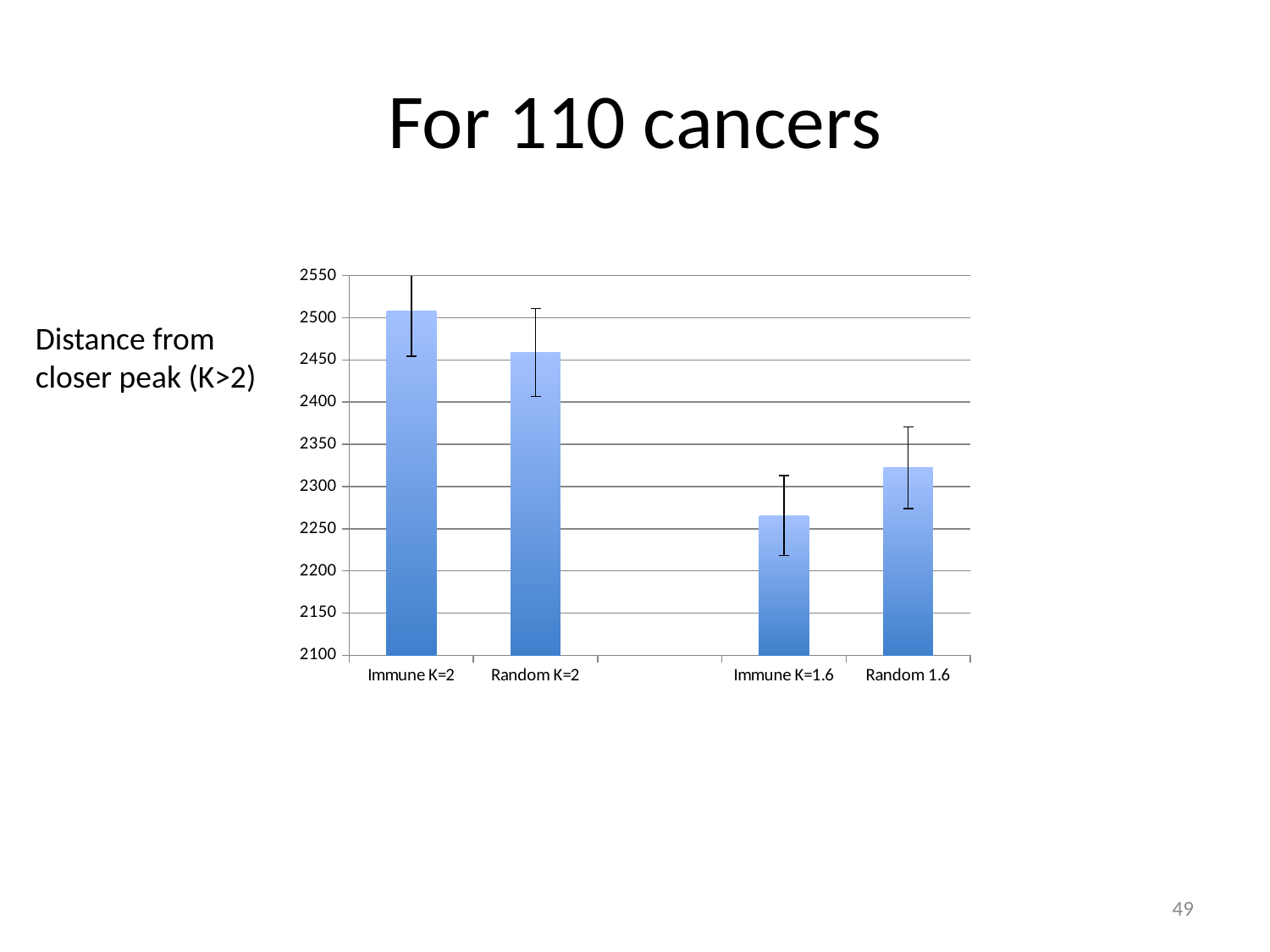
What is the title of the slide containing the chart? For 110 cancers Is the value for Immune K=2 greater or less than 2450? greater Which is larger, the value for Immune K=1.6 or the value for Random 1.6? Random 1.6 Is the value for Immune K=1.6 greater or less than 2300? less Which is larger, the value for Immune K=2 or the value for Random K=2? Immune K=2 Which category has the highest bar? Immune K=2 Which category has the lowest bar? Immune K=1.6 Is the value for Random K=2 greater or less than 2400? greater What quantity does the text to the left of the chart say the bars represent? Distance from closer peak (K>2) What kind of chart is shown on the slide? bar chart How many bars are plotted in the chart? 4